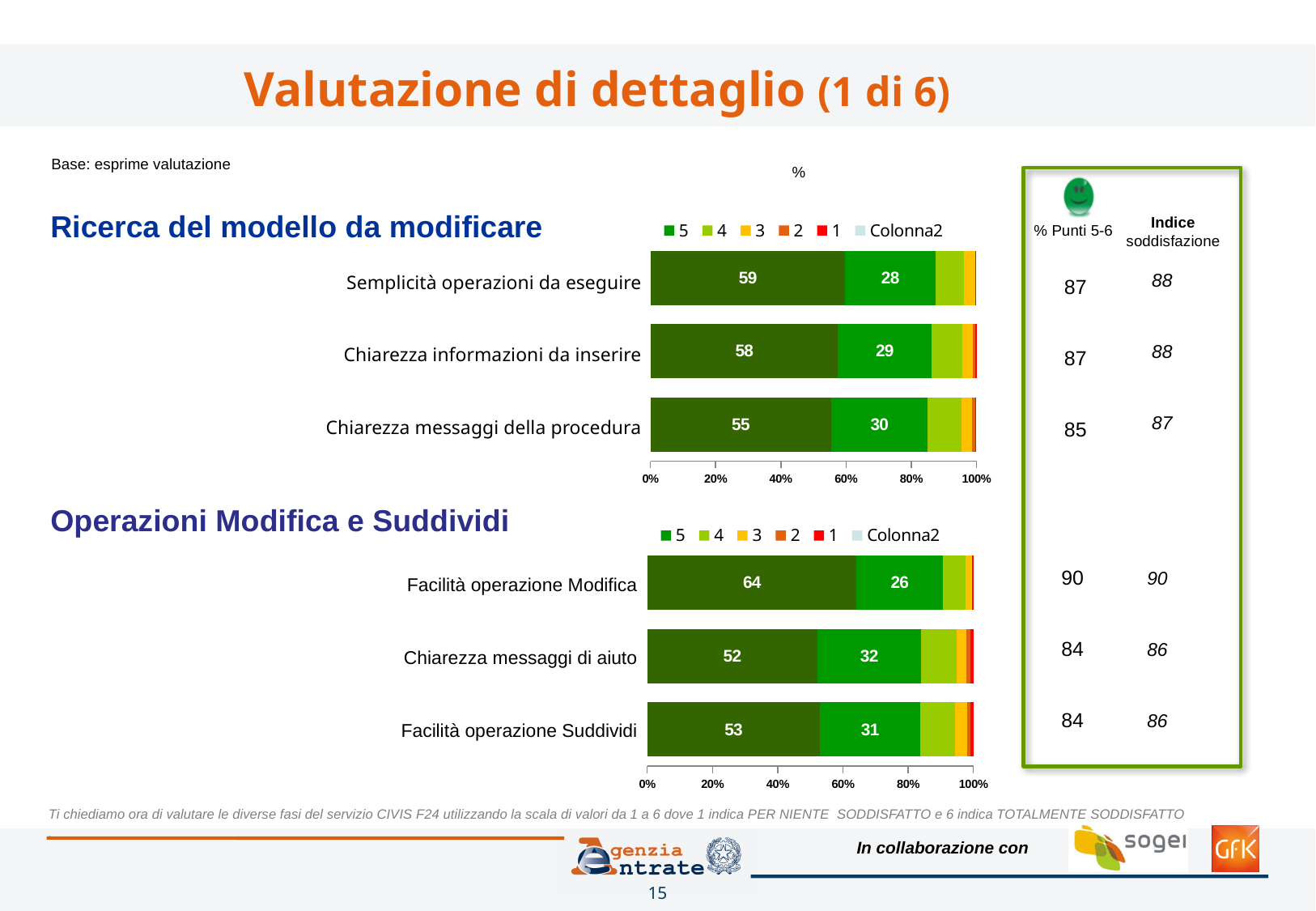
What type of chart is the 'Ricerca del modello da modificare' chart? Stacked bar chart In the 'Ricerca del modello da modificare' chart, is the series 5 value larger for 'Chiarezza informazioni da inserire' or for 'Chiarezza messaggi della procedura'? Chiarezza messaggi della procedura How many categories are shown in the 'Operazioni Modifica e Suddividi' chart? 3 In the 'Operazioni Modifica e Suddividi' chart, what is the value of series 5 for 'Facilità operazione Modifica'? 26 In the 'Operazioni Modifica e Suddividi' chart, which category has the lowest value for series 5? Facilità operazione Modifica In the 'Operazioni Modifica e Suddividi' chart, what is the difference between the series 5 values for 'Facilità operazione Modifica' and 'Facilità operazione Suddividi'? 5 How many series does the legend of the 'Ricerca del modello da modificare' chart list? 6 In the 'Ricerca del modello da modificare' chart, which category has the highest value for series 5? Chiarezza messaggi della procedura In the 'Operazioni Modifica e Suddividi' chart, what is the last entry in the legend? Colonna2 In the 'Ricerca del modello da modificare' chart, what is the value of series 5 for 'Semplicità operazioni da eseguire'? 28